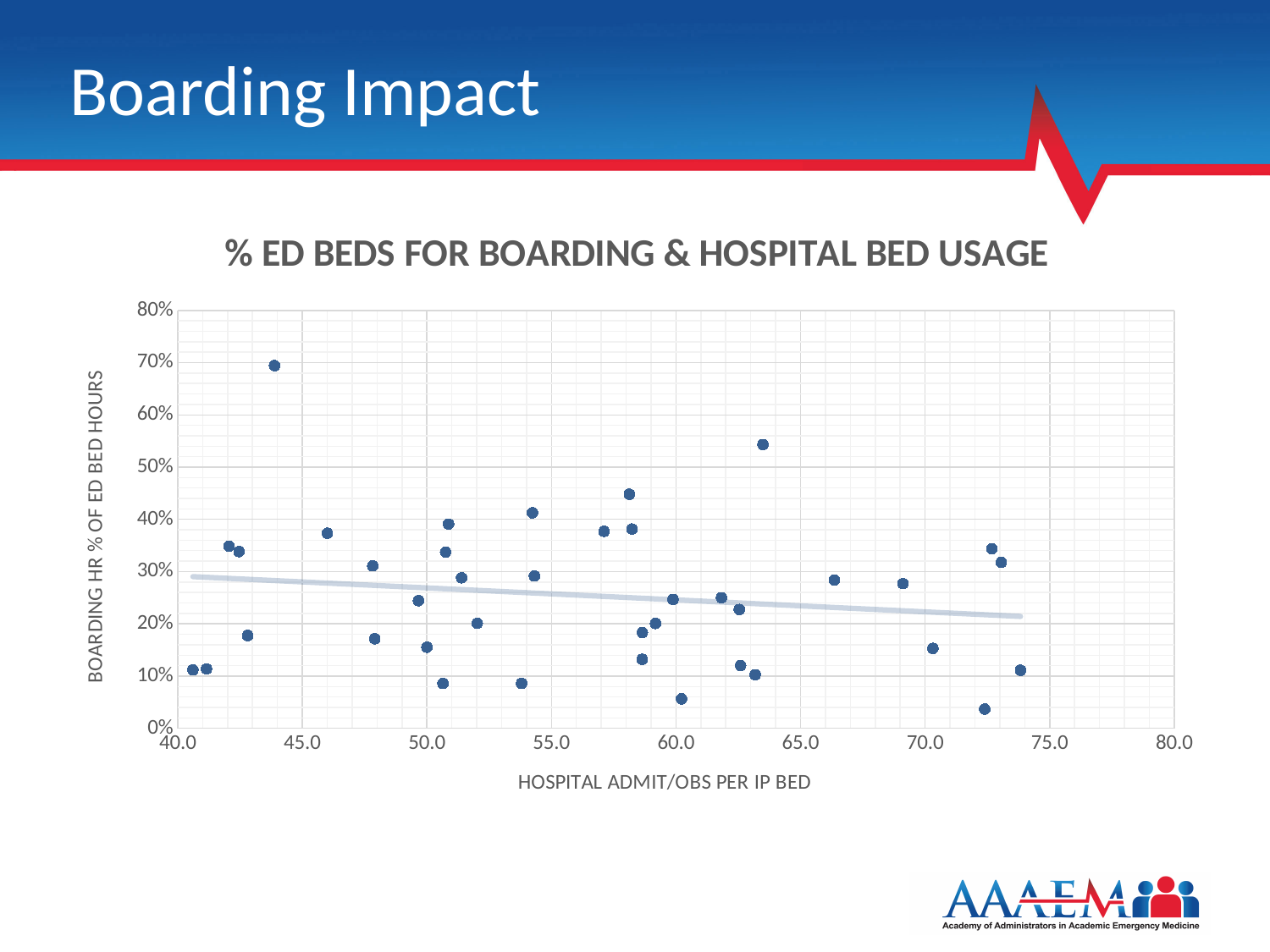
Is the boarding percentage of the point with the largest x value (near 74) greater or less than 20%? less What kind of chart is shown on the slide? Scatter plot Is the boarding percentage of the point near 63.5 on the x axis greater or less than 50%? greater Is the boarding percentage of the highest plotted point greater or less than 60%? greater What is the label of the x axis of the chart? HOSPITAL ADMIT/OBS PER IP BED What is the title of the chart? % ED BEDS FOR BOARDING & HOSPITAL BED USAGE Which has the higher boarding percentage: the point near 44 on the x axis or the point near 63.5 on the x axis? The point near 44 Does the trend line on the chart rise or fall as hospital admit/obs per IP bed increases? Fall